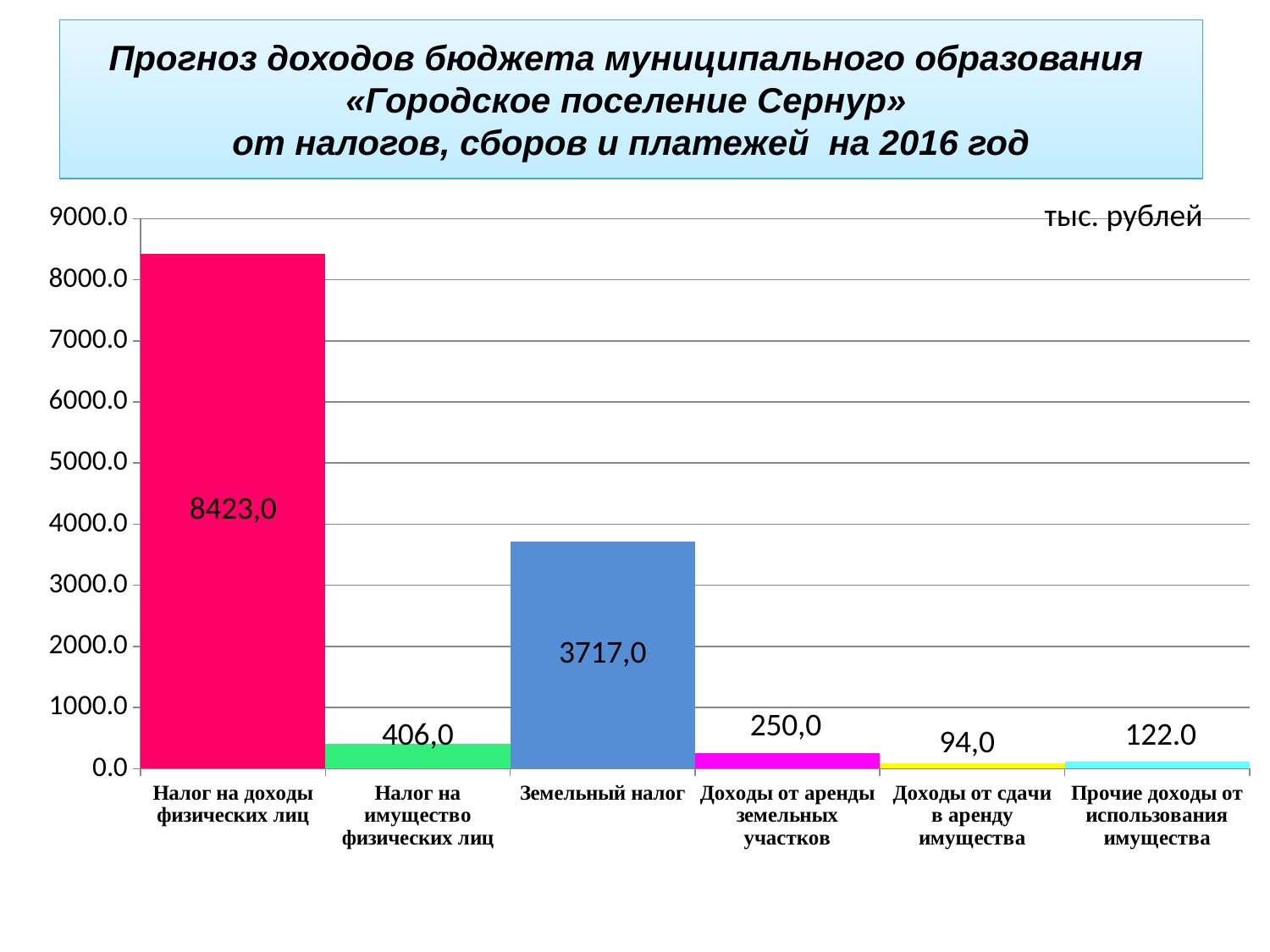
How many categories are shown on the chart? 6 What is the difference between the values for Налог на доходы физических лиц and Земельный налог? 4706,0 What is the value for Налог на доходы физических лиц? 8423,0 What is the value for Прочие доходы от использования имущества? 122.0 What kind of chart is shown on the slide? bar chart Which category has the lowest value? Доходы от сдачи в аренду имущества Which is larger: the value for Налог на имущество физических лиц or the value for Доходы от аренды земельных участков? Налог на имущество физических лиц Which category has the highest value? Налог на доходы физических лиц What is the value for Доходы от сдачи в аренду имущества? 94,0 What is the value for Земельный налог? 3717,0 Is the value for Земельный налог greater or less than 4000.0? less What unit is indicated in the top right corner of the chart? тыс. рублей